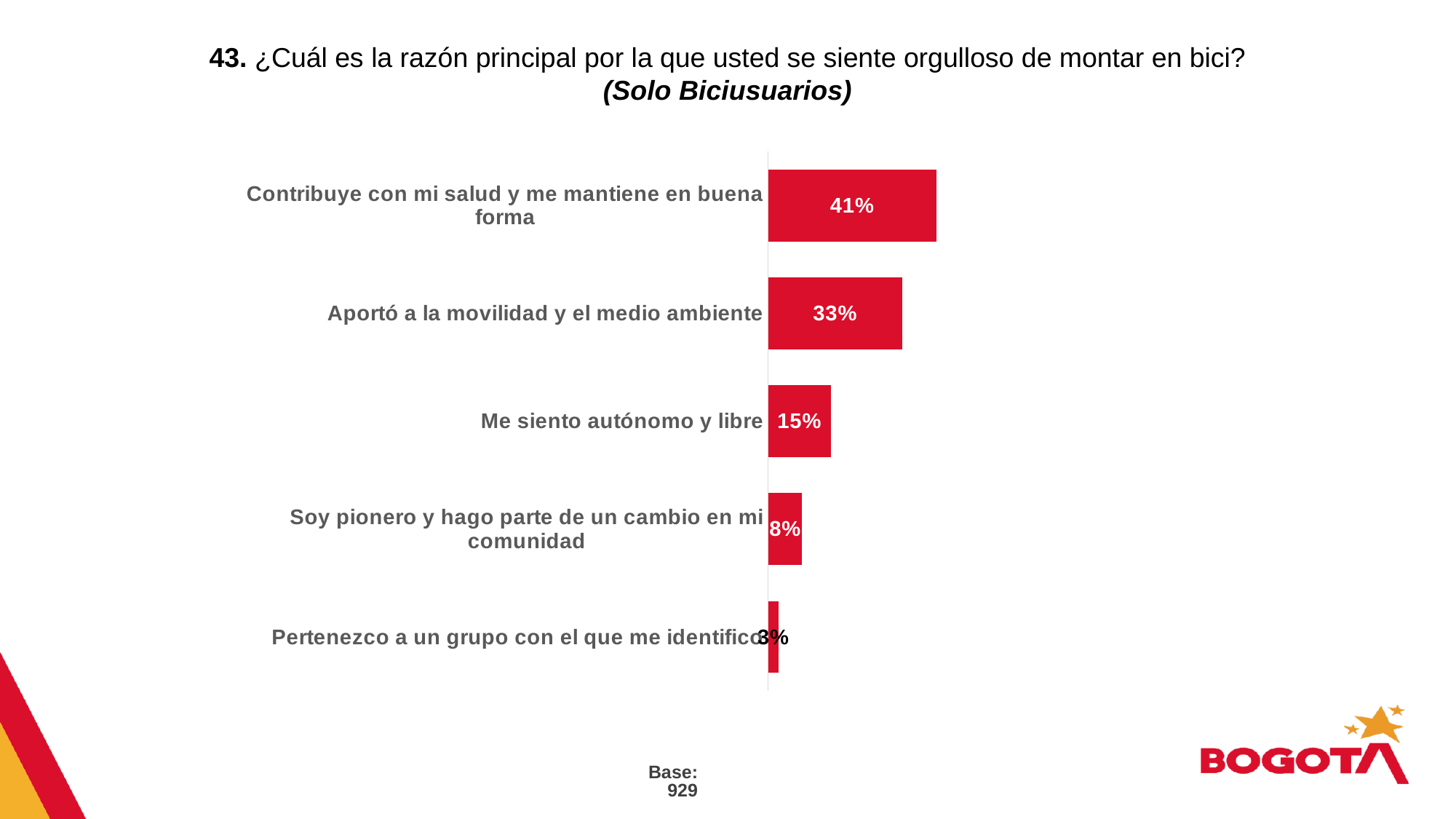
Which reason has the lowest percentage? Pertenezco a un grupo con el que me identifico Which is larger: the value for "Me siento autónomo y libre" or for "Soy pionero y hago parte de un cambio en mi comunidad"? Me siento autónomo y libre What is the difference in percentage points between "Contribuye con mi salud y me mantiene en buena forma" and "Aportó a la movilidad y el medio ambiente"? 8 percentage points What percentage is shown for "Contribuye con mi salud y me mantiene en buena forma"? 41% Which reason has the highest percentage? Contribuye con mi salud y me mantiene en buena forma How many reasons (categories) are shown in the chart? 5 What percentage is shown for "Me siento autónomo y libre"? 15% What percentage is shown for "Pertenezco a un grupo con el que me identifico"? 3% What is the base (number of respondents) shown below the chart? 929 What kind of chart is shown on the slide? Bar chart What percentage is shown for "Aportó a la movilidad y el medio ambiente"? 33% What percentage is shown for "Soy pionero y hago parte de un cambio en mi comunidad"? 8%